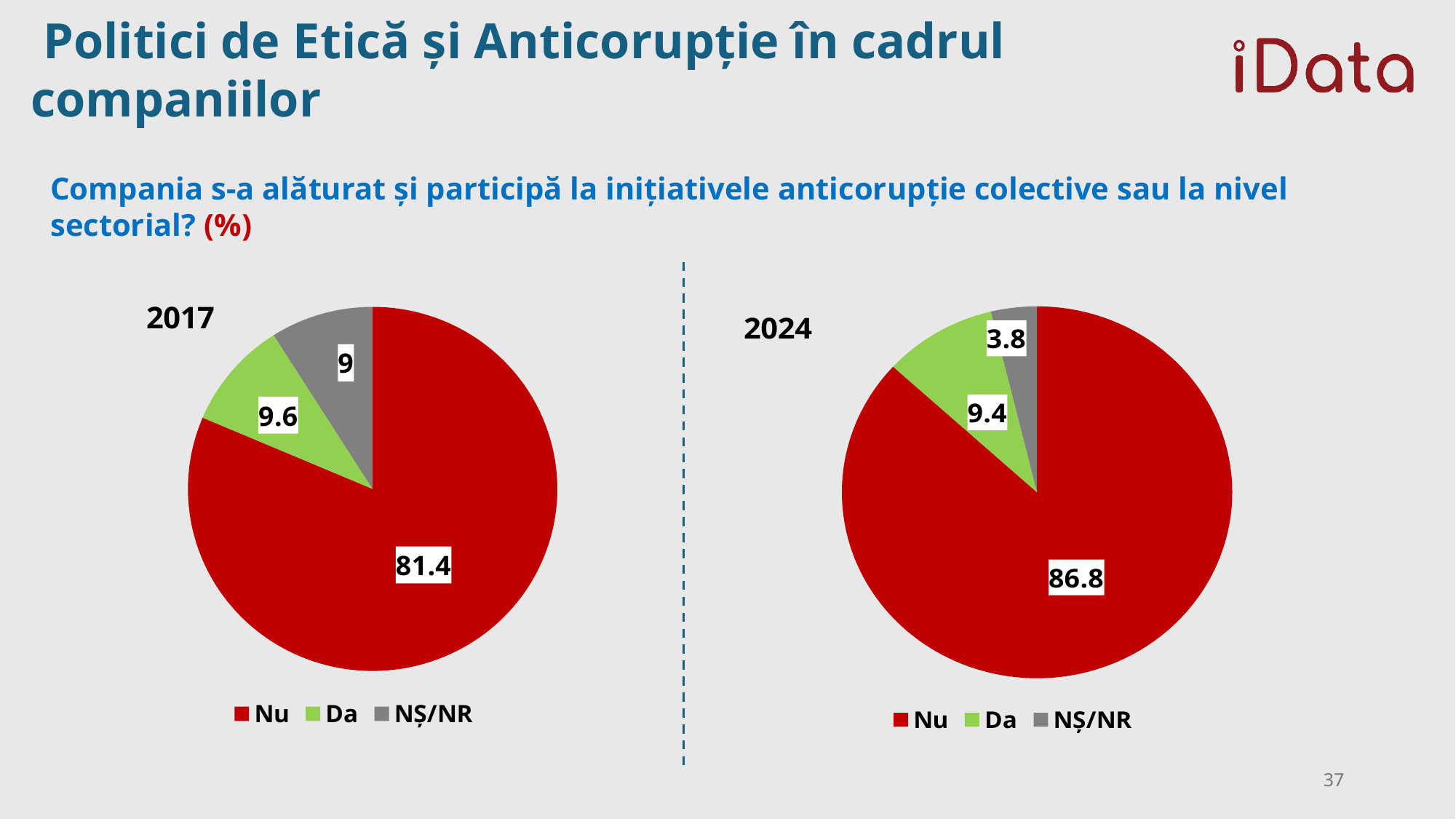
In the 2024 pie chart, what is the value for NȘ/NR? 3.8 What is the difference between the Nu value in the 2024 chart and the Nu value in the 2017 chart? 5.4 In the 2017 pie chart, what is the difference between the Da and NȘ/NR values? 0.6 In the 2017 pie chart, what is the value for Nu? 81.4 What type of chart is used on this slide? Pie chart What colour represents Da in the legends? Green How many slices does the 2024 pie chart have? 3 In the 2024 pie chart, what is the value for Da? 9.4 In the 2024 pie chart, which category has the smallest slice? NȘ/NR In the 2017 pie chart, what is the value for NȘ/NR? 9 Is the NȘ/NR value larger in the 2017 chart or the 2024 chart? 2017 In the 2017 pie chart, which category has the largest slice? Nu